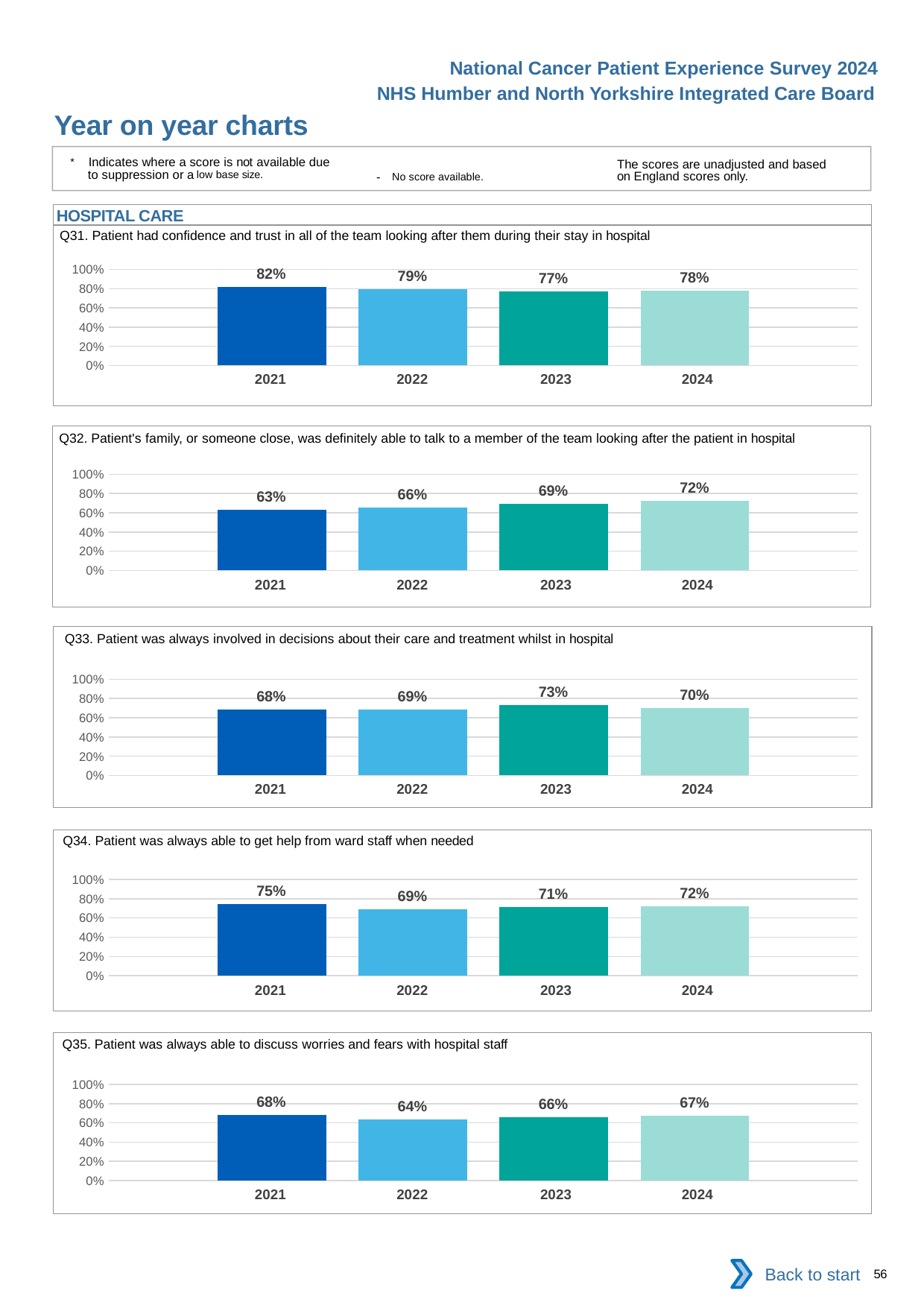
In the Q34 chart (patient was always able to get help from ward staff), which year has the lowest value? 2022 In the Q35 chart, is the value for 2024 greater or less than 60%? greater How many years are shown in the Q34 chart? 4 In the Q35 chart (patient was always able to discuss worries and fears), what is the difference between the 2021 and 2022 values? 4% In the Q31 chart (patient had confidence and trust in all of the team), what is the value for 2021? 82% What kind of chart is the Q33 chart? bar chart In the Q31 chart, is the value for 2022 or 2024 larger? 2022 In the Q34 chart, what is the difference between the 2021 and 2024 values? 3% In the Q33 chart (patient was always involved in decisions about their care), what is the value for 2023? 73% In the Q32 chart (patient's family was definitely able to talk to a member of the team), which year has the highest value? 2024 In the Q32 chart, do the values rise or fall from 2021 to 2024? rise What is the section heading above the Q31 chart? HOSPITAL CARE